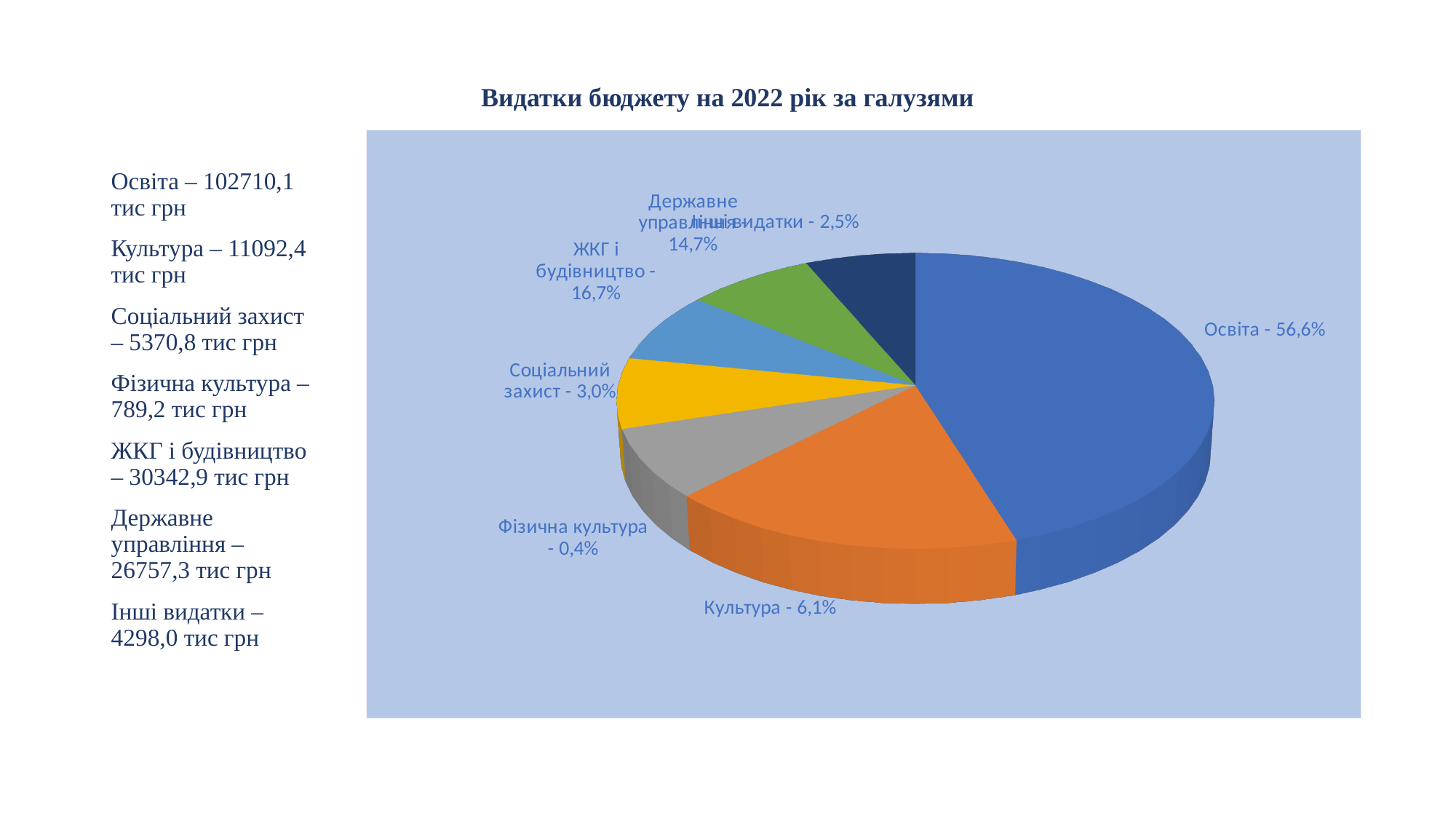
How many slices does the pie chart have? 7 What share of the pie does Державне управління have? 14,7% What share of the pie does Культура have? 6,1% Which slice is larger, Соціальний захист or Інші видатки? Соціальний захист What share of the pie does Фізична культура have? 0,4% What is the difference in percentage points between the Освіта slice and the ЖКГ і будівництво slice? 39,9% What is the title of the chart? Видатки бюджету на 2022 рік за галузями What kind of chart is shown on the slide? pie chart Which category has the largest slice of the pie? Освіта